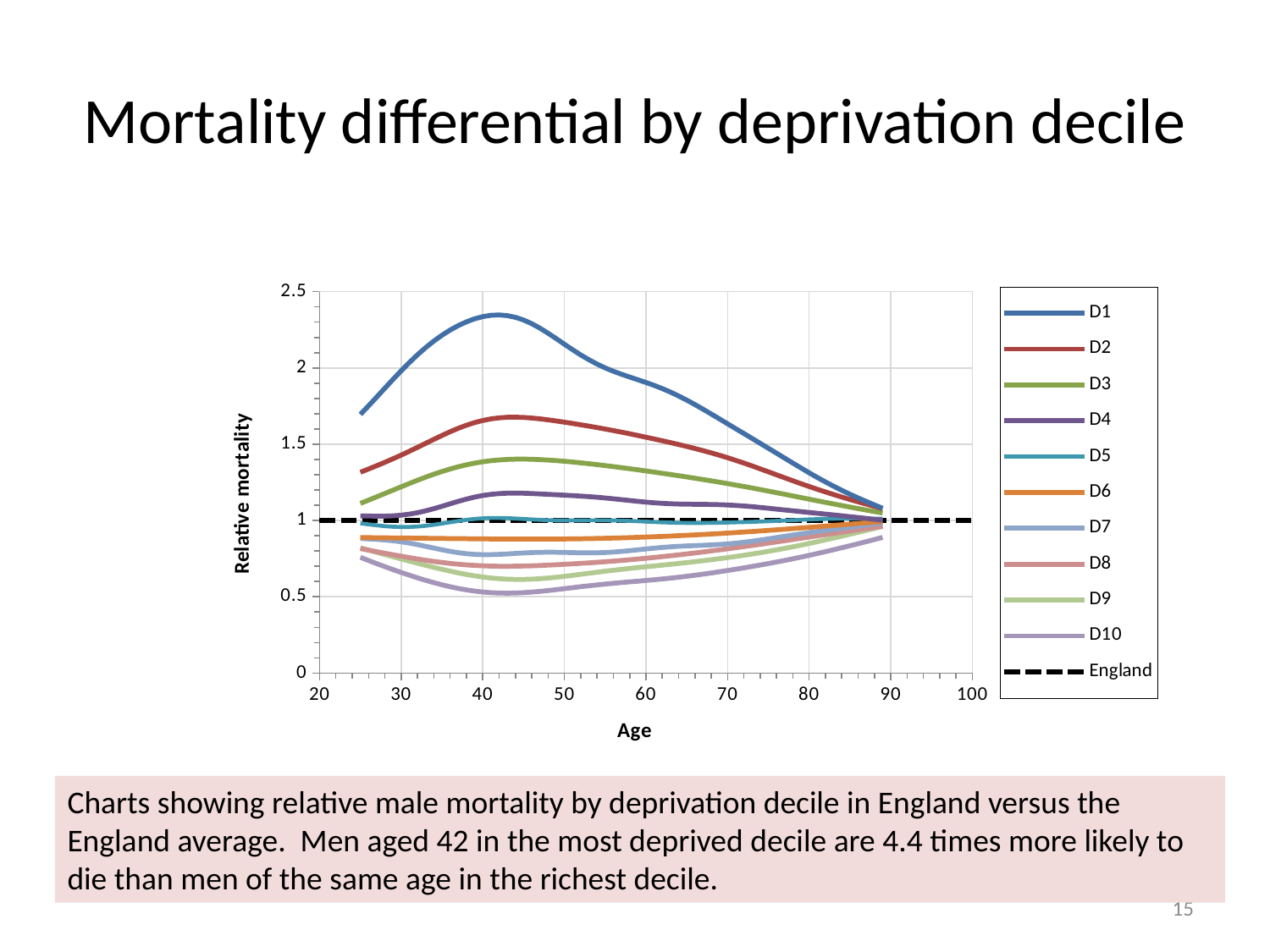
Is the value for D1 at age 40 greater or less than 2? greater What is the label of the vertical axis? Relative mortality At what relative mortality value does the dashed England line sit? 1 Does the D1 line rise or fall between age 45 and age 90? fall What kind of chart is shown on the slide? line chart What is the label of the horizontal axis? Age Which series has the lowest relative mortality around age 40? D10 Is the value for D2 at age 45 greater or less than 1.5? greater How many series does the legend list? 11 At age 40, which series has the larger value, D1 or D2? D1 Which series reaches the highest relative mortality on the chart? D1